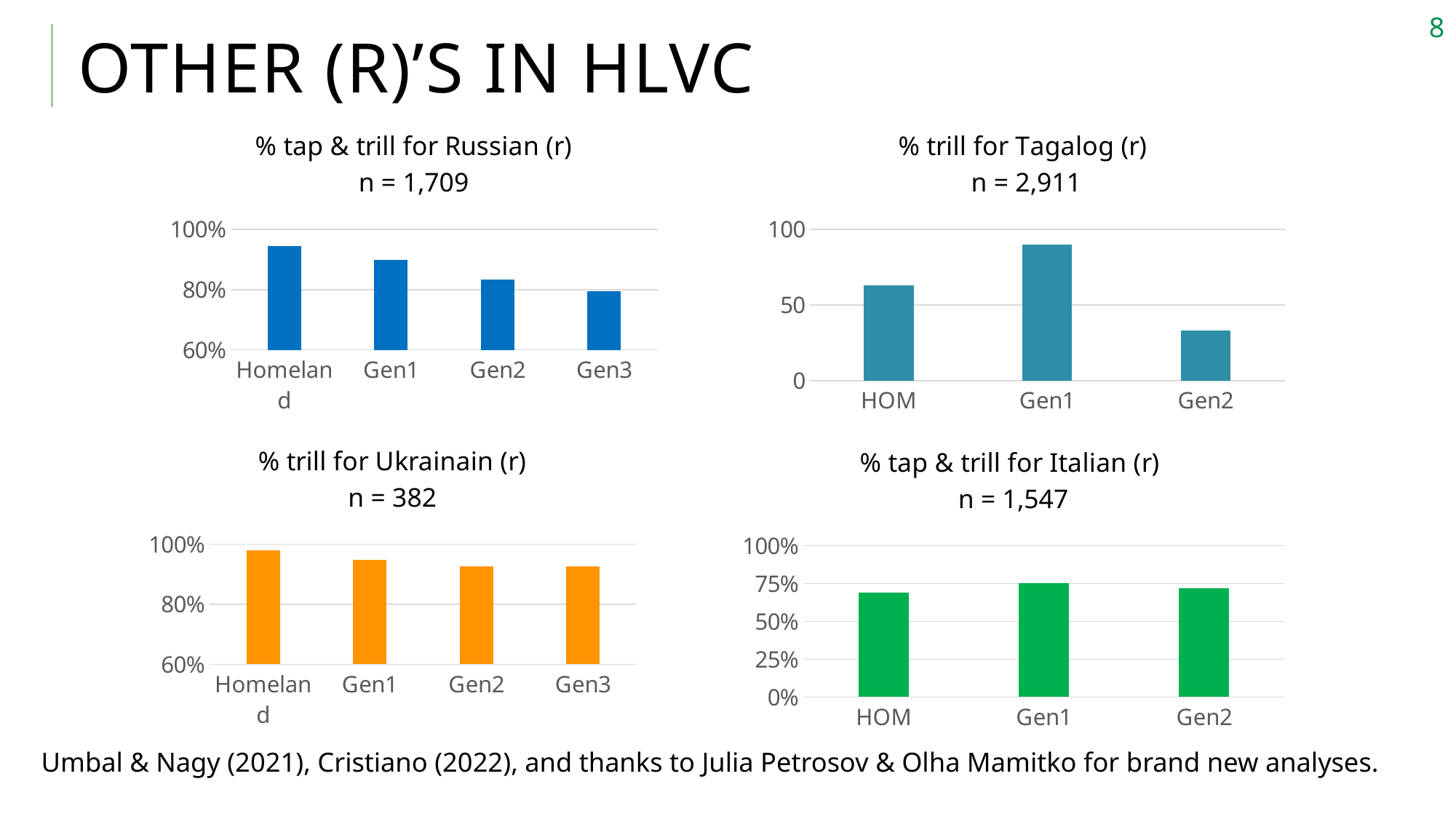
In the '% tap & trill for Russian (r)' chart, is the value for Gen2 greater or less than 80%? greater What kind of chart is the '% tap & trill for Italian (r)' chart? bar chart In the '% tap & trill for Russian (r)' chart, which generation has the lowest value? Gen3 In the '% trill for Tagalog (r)' chart, is the value for Gen2 greater or less than 50? less In the '% trill for Tagalog (r)' chart, which group has the highest value? Gen1 In the '% trill for Tagalog (r)' chart, which group has the lowest value? Gen2 In the '% trill for Tagalog (r)' chart, how many groups are plotted? 3 In the '% tap & trill for Italian (r)' chart, is the value for HOM greater or less than 75%? less In the '% trill for Ukrainain (r)' chart, which generation has the highest value? Homeland In the '% tap & trill for Russian (r)' chart, do the values rise or fall from Homeland to Gen3? fall In the '% tap & trill for Russian (r)' chart, which generation has the highest value? Homeland